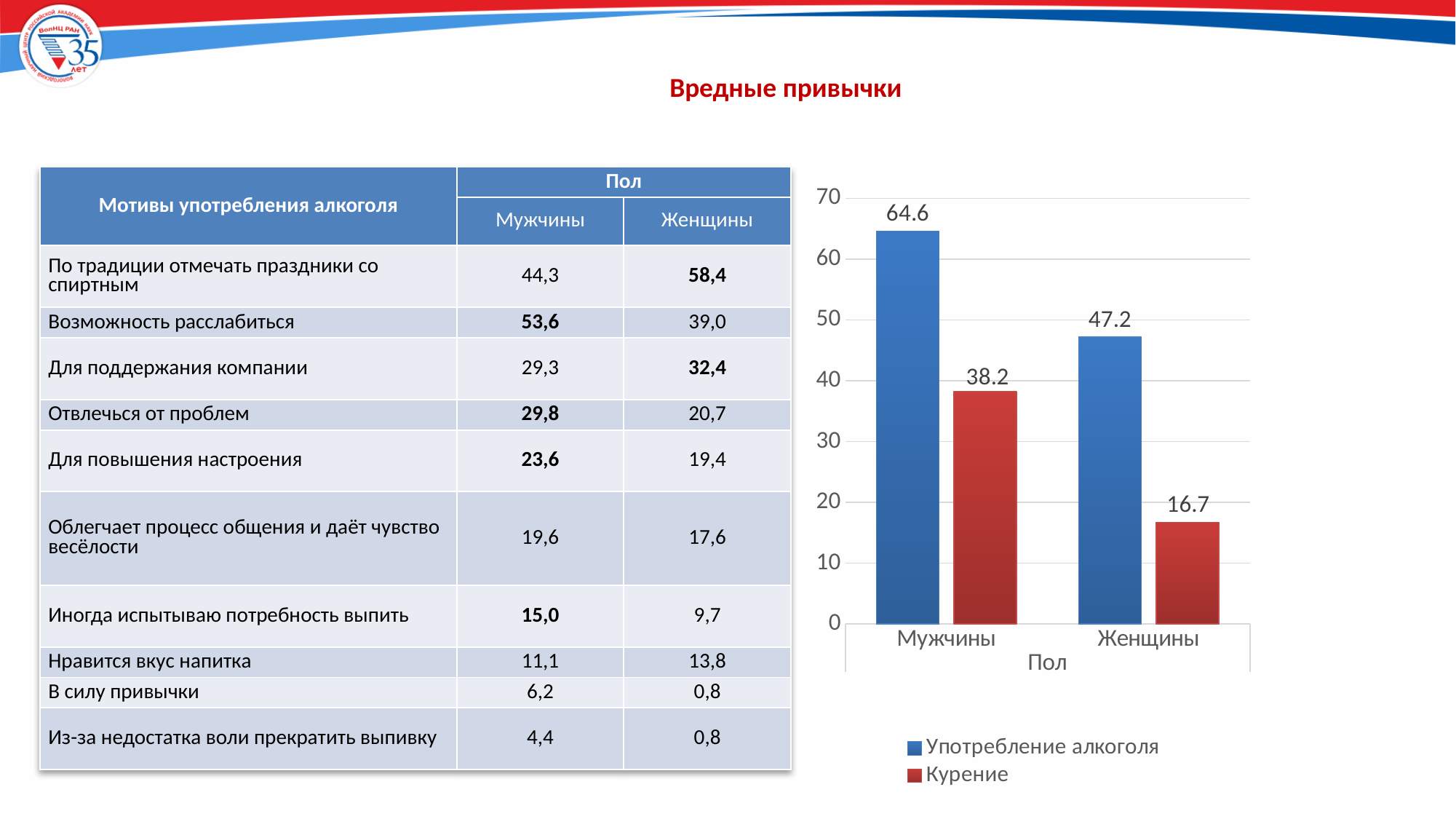
What is the difference between the Употребление алкоголя values for Мужчины and Женщины in the chart? 17.4 What is the value for Курение among Мужчины in the bar chart? 38.2 How many series does the chart legend list? 2 What is the value for Употребление алкоголя among Мужчины in the bar chart? 64.6 In the chart, which is larger: Курение for Мужчины or Употребление алкоголя for Женщины? Употребление алкоголя for Женщины What is the value for Употребление алкоголя among Женщины in the bar chart? 47.2 What type of chart is shown on the right of the slide? Bar chart What is the value for Курение among Женщины in the bar chart? 16.7 Which bar in the chart has the lowest value? Курение, Женщины What is the difference between the Курение values for Мужчины and Женщины in the chart? 21.5 Which bar in the chart has the highest value? Употребление алкоголя, Мужчины How many categories are shown on the x axis of the bar chart? 2